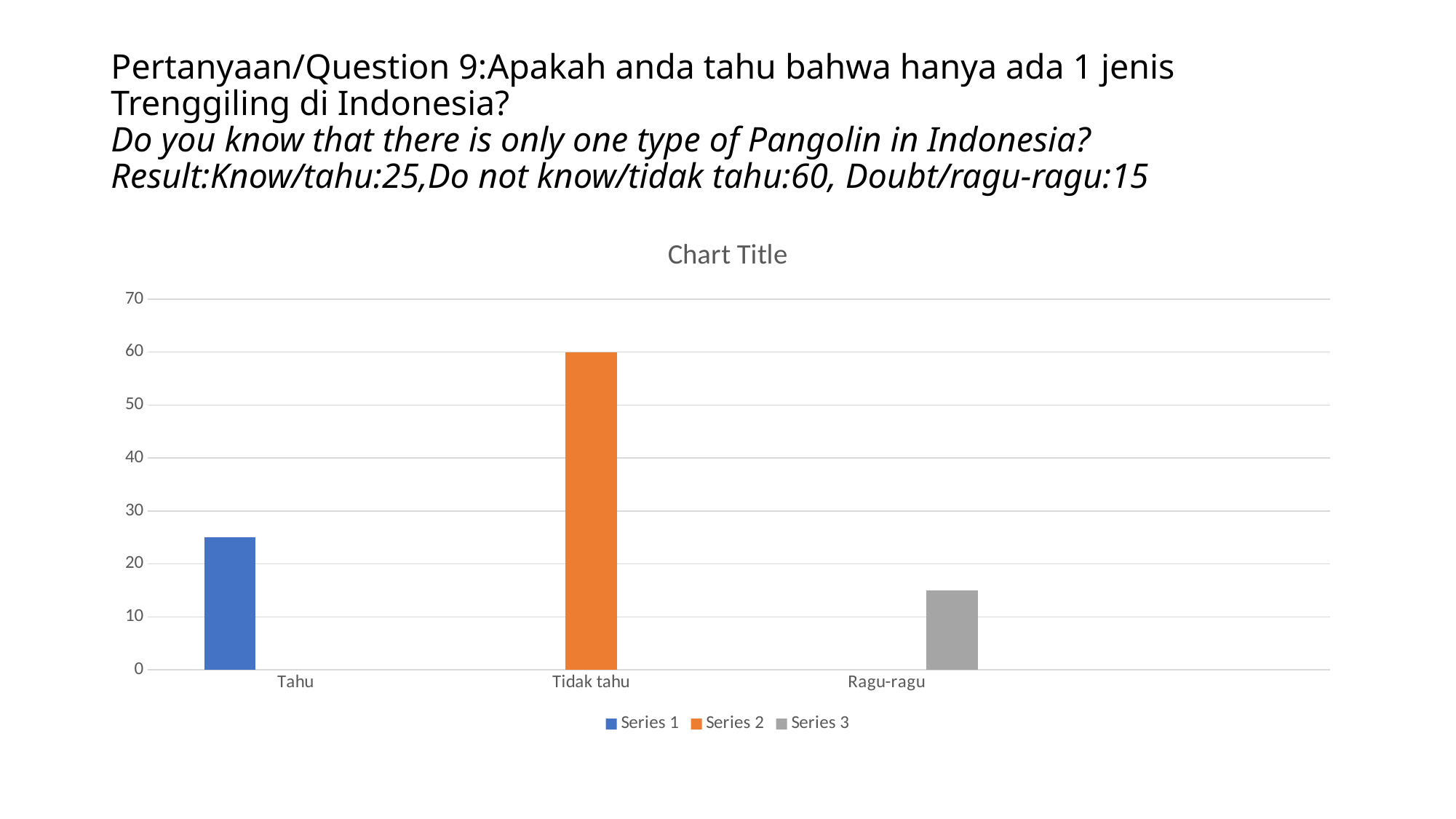
How many categories are shown on the x axis? 3 What is the value for Ragu-ragu? 15 Which category has the lowest value? Ragu-ragu What kind of chart is shown on the slide? bar chart How many series does the legend list? 3 What is the value for Tidak tahu? 60 Is the value for Tahu greater or less than 30? less Which is larger, the value for Tahu or the value for Ragu-ragu? Tahu What is the value for Tahu? 25 What is the difference between the values for Tidak tahu and Tahu? 35 What is the difference between the values for Tahu and Ragu-ragu? 10 Which category has the highest value? Tidak tahu